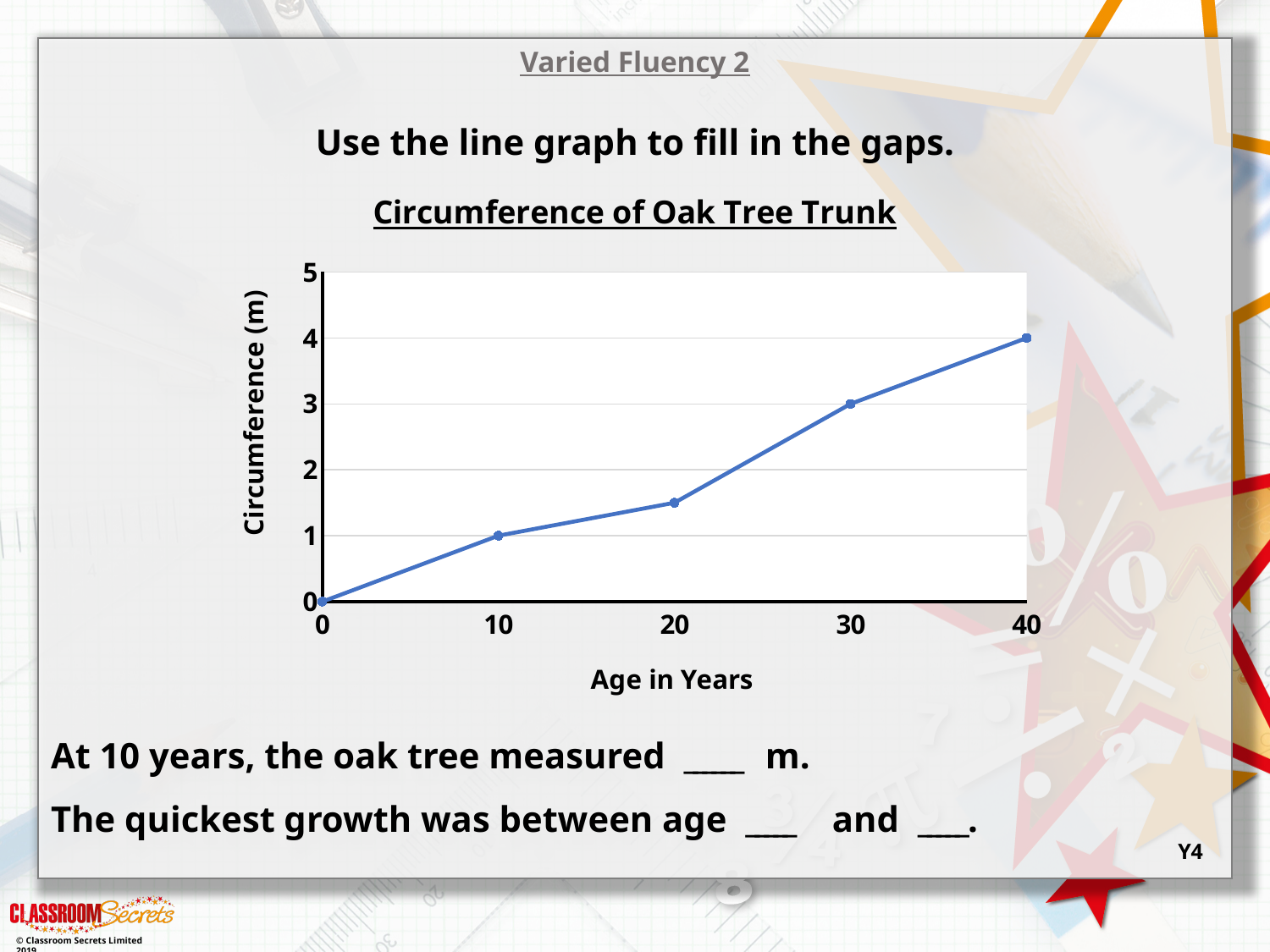
What kind of chart is shown on the slide? line chart How many data points are plotted on the line? 5 Is the circumference at 20 years greater or less than 1 m? greater Is the circumference at 20 years greater or less than 2 m? less At which age is the circumference highest? 40 years By how much does the circumference increase between 10 years and 30 years? 2 m What is the title of the chart? Circumference of Oak Tree Trunk What is the circumference of the oak tree trunk at 30 years? 3 m What is the circumference of the oak tree trunk at 10 years? 1 m Does the circumference rise or fall as age increases? rise What is the circumference of the oak tree trunk at 40 years? 4 m What is the circumference of the oak tree trunk at age 0? 0 m